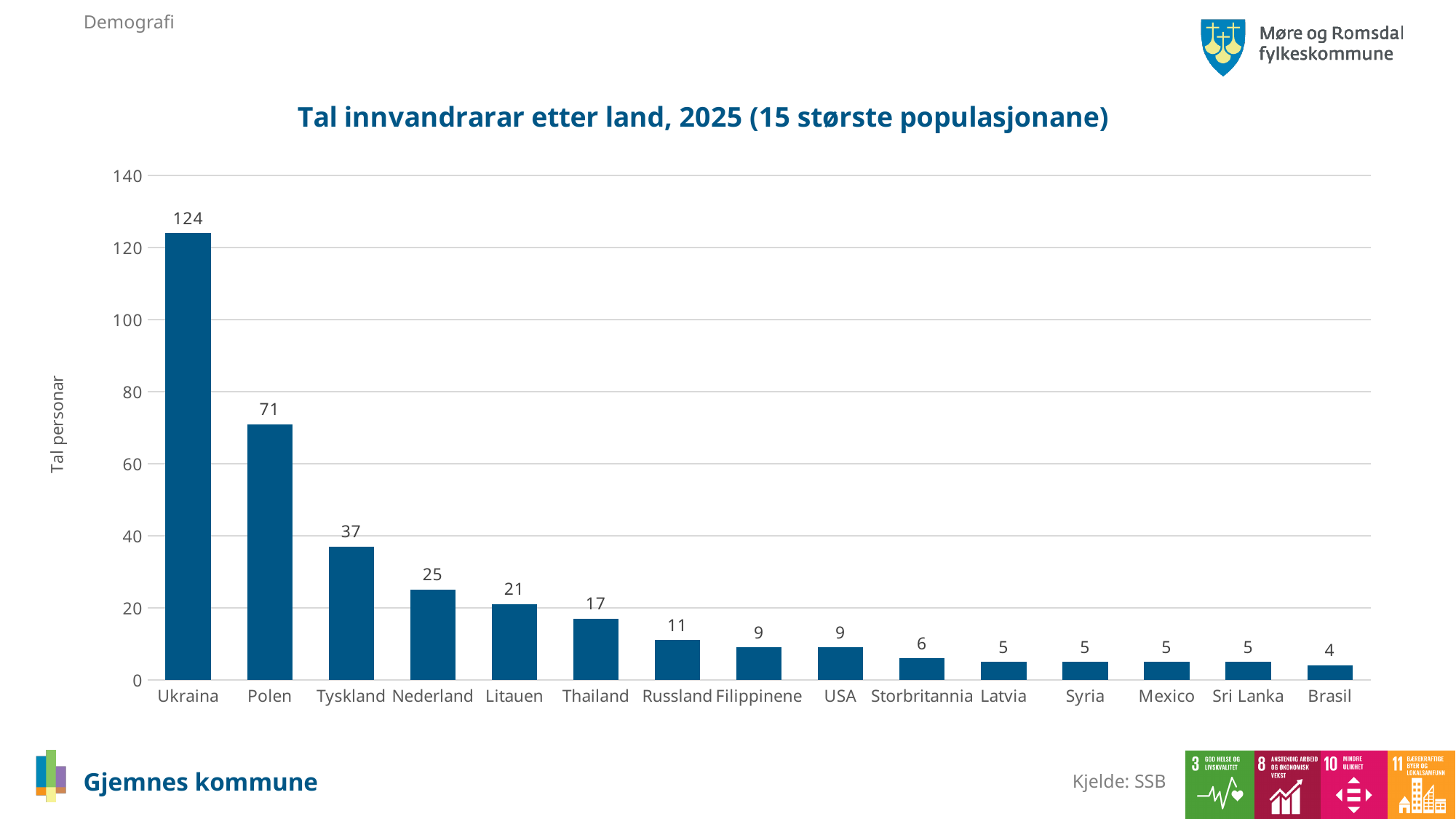
How many countries are shown on the x axis? 15 Which is larger, the value for Nederland or the value for Litauen? Nederland What is the value for Ukraina? 124 What is the title of the chart? Tal innvandrarar etter land, 2025 (15 største populasjonane) Which country has the lowest value? Brasil Which country has the highest value? Ukraina Is the value for Polen greater or less than 80? less What kind of chart is this? bar chart What is the difference between the values for Ukraina and Polen? 53 What is the value for Tyskland? 37 What is the value for Thailand? 17 Do the values rise or fall from left to right along the x axis? fall